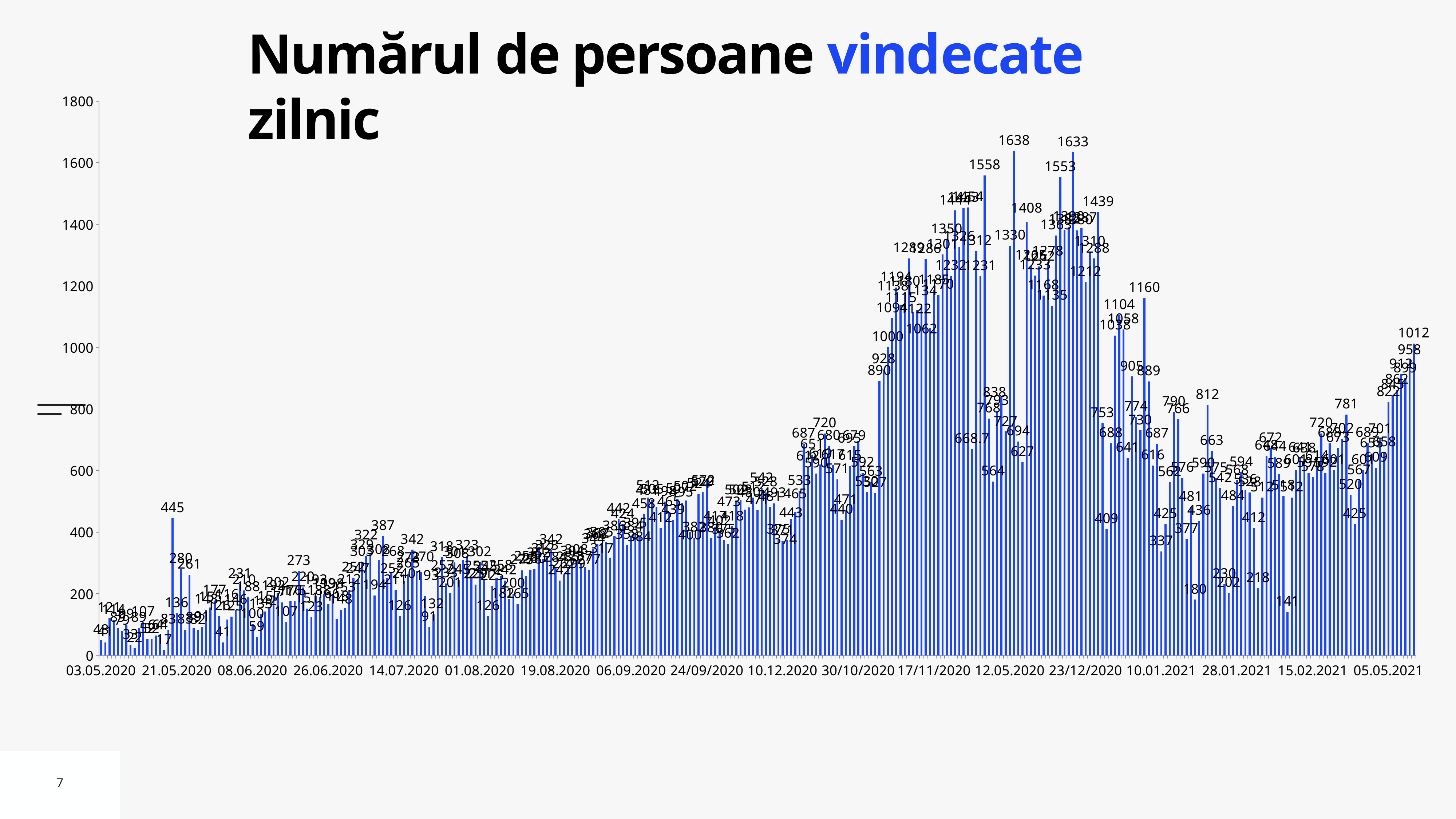
What is the maximum value shown on the vertical axis? 1800 What kind of chart is shown on the slide? bar chart Which is larger, the bar labelled 1558 or the bar labelled 1408? 1558 What is the value of the last bar on the right of the chart? 1012 What is the difference between the two highest labelled values, 1638 and 1633? 5 Do the values generally rise or fall from 03.05.2020 to 17/11/2020? rise Is the value of the bar labelled 812 between 10.01.2021 and 28.01.2021 greater or less than 800? greater What is the highest value labelled on the chart? 1638 What is the title of the chart? Numărul de persoane vindecate zilnic Is the value of the spike labelled 445 near 21.05.2020 greater or less than 400? greater What is the value of the tall isolated spike shortly after 21.05.2020? 445 What is the difference between the highest value, 1638, and the value 1558? 80